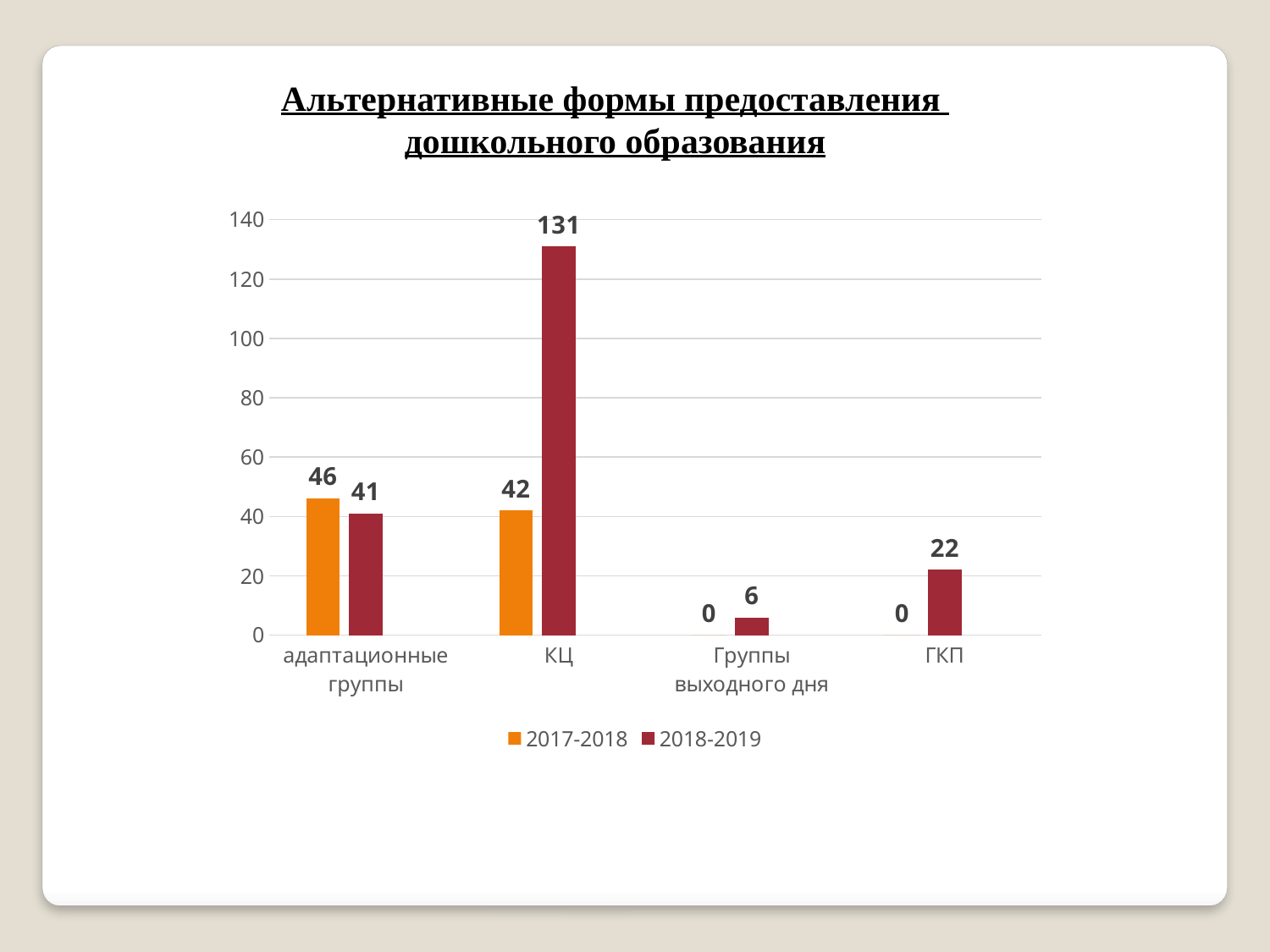
What is the value for КЦ in the 2018-2019 series? 131 What is the difference between the 2018-2019 and 2017-2018 values for КЦ? 89 What is the value for адаптационные группы in the 2017-2018 series? 46 How many series does the legend list? 2 Which category has the highest value in the 2018-2019 series? КЦ How many categories are shown on the x axis? 4 What is the value for Группы выходного дня in the 2017-2018 series? 0 Which category has the lowest value in the 2018-2019 series? Группы выходного дня What kind of chart is shown on the slide? Bar chart What is the value for ГКП in the 2018-2019 series? 22 Which is larger for адаптационные группы: the 2017-2018 value or the 2018-2019 value? 2017-2018 What colour represents the 2017-2018 series? Orange